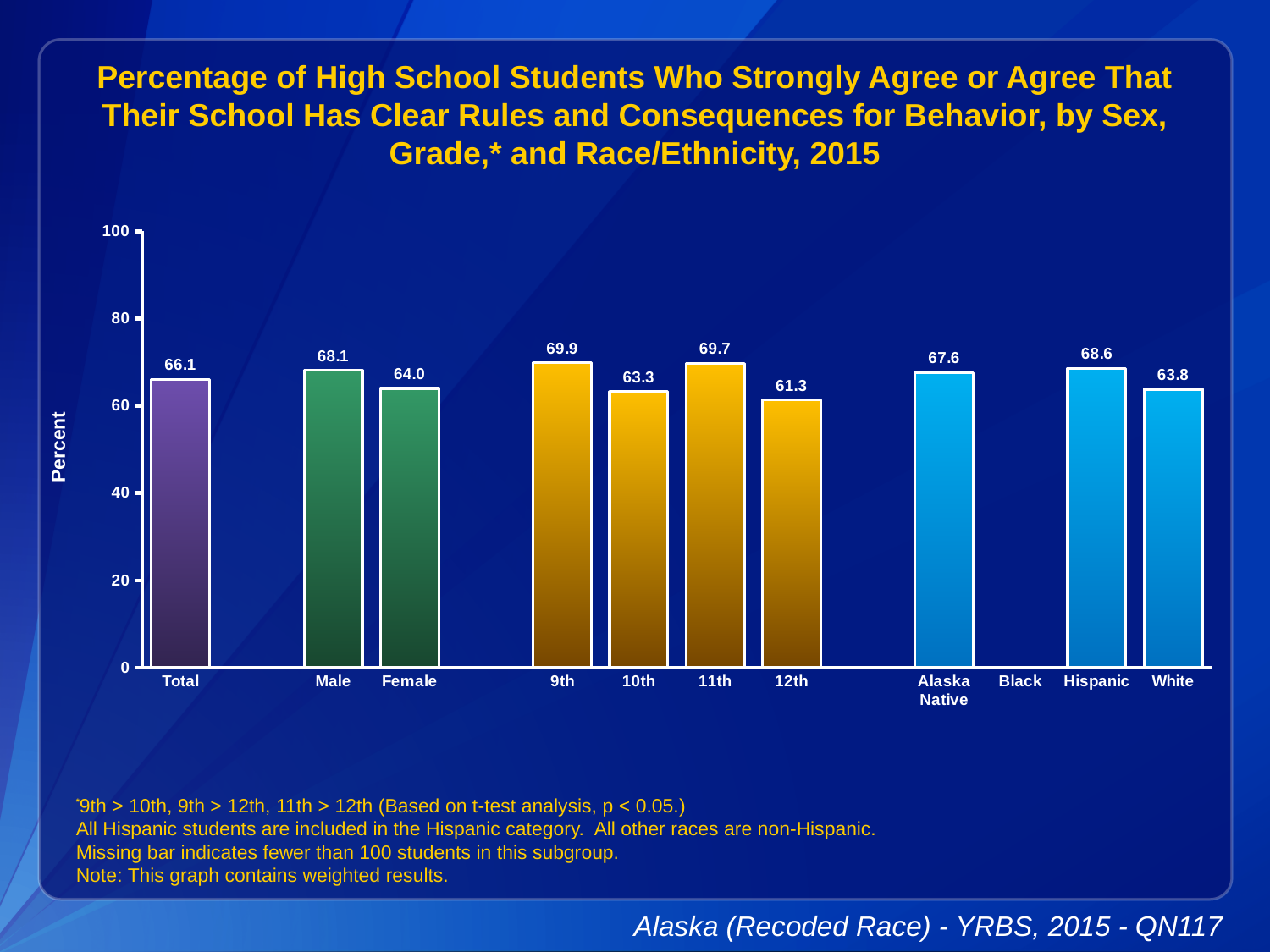
Is the value for 10th grade greater or less than 60? greater What is the value for Female? 64.0 What is the value for 12th grade? 61.3 What is the difference between the Male and Female values? 4.1 Which is larger, the value for Hispanic or the value for White? Hispanic How many bars are plotted on the chart? 10 What kind of chart is shown? bar chart Which category has the lowest value among the bars shown? 12th Which category has the highest value? 9th What is the value for Total? 66.1 Which category has no bar shown? Black What is the value for Alaska Native? 67.6